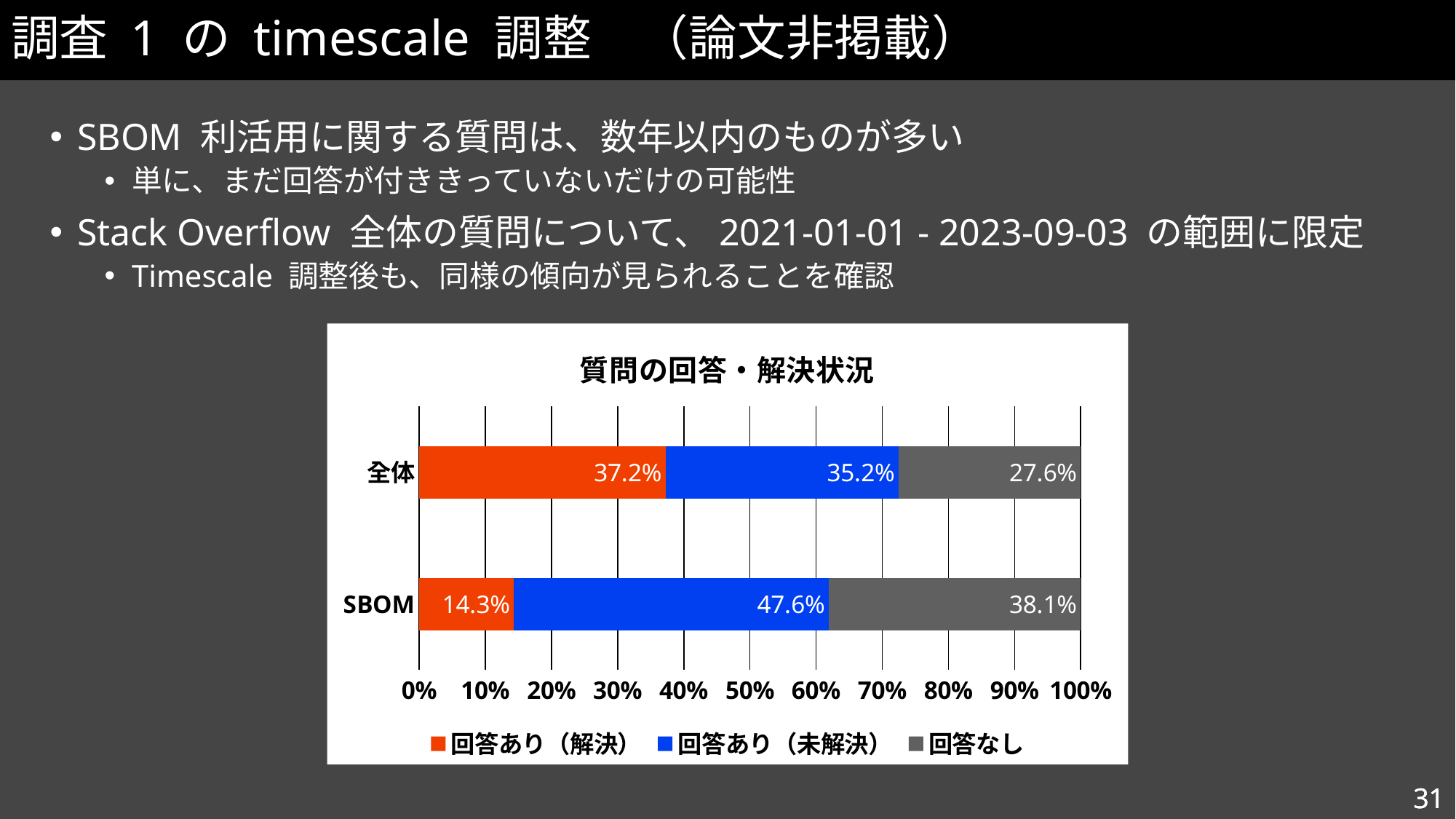
What is the value for 回答あり（解決） in the 全体 bar? 37.2% What kind of chart is shown on the slide? Stacked horizontal bar chart Which category has the higher value for 回答なし, 全体 or SBOM? SBOM What is the title of the chart? 質問の回答・解決状況 How many series does the legend list? 3 What is the value for 回答なし in the 全体 bar? 27.6% What is the difference between the 回答なし values for SBOM and 全体? 10.5% How many categories are shown on the chart? 2 What is the value for 回答あり（未解決） in the SBOM bar? 47.6% What is the value for 回答なし in the SBOM bar? 38.1% What is the difference between the 回答あり（解決） values for 全体 and SBOM? 22.9% Which category has the higher value for 回答あり（解決）, 全体 or SBOM? 全体